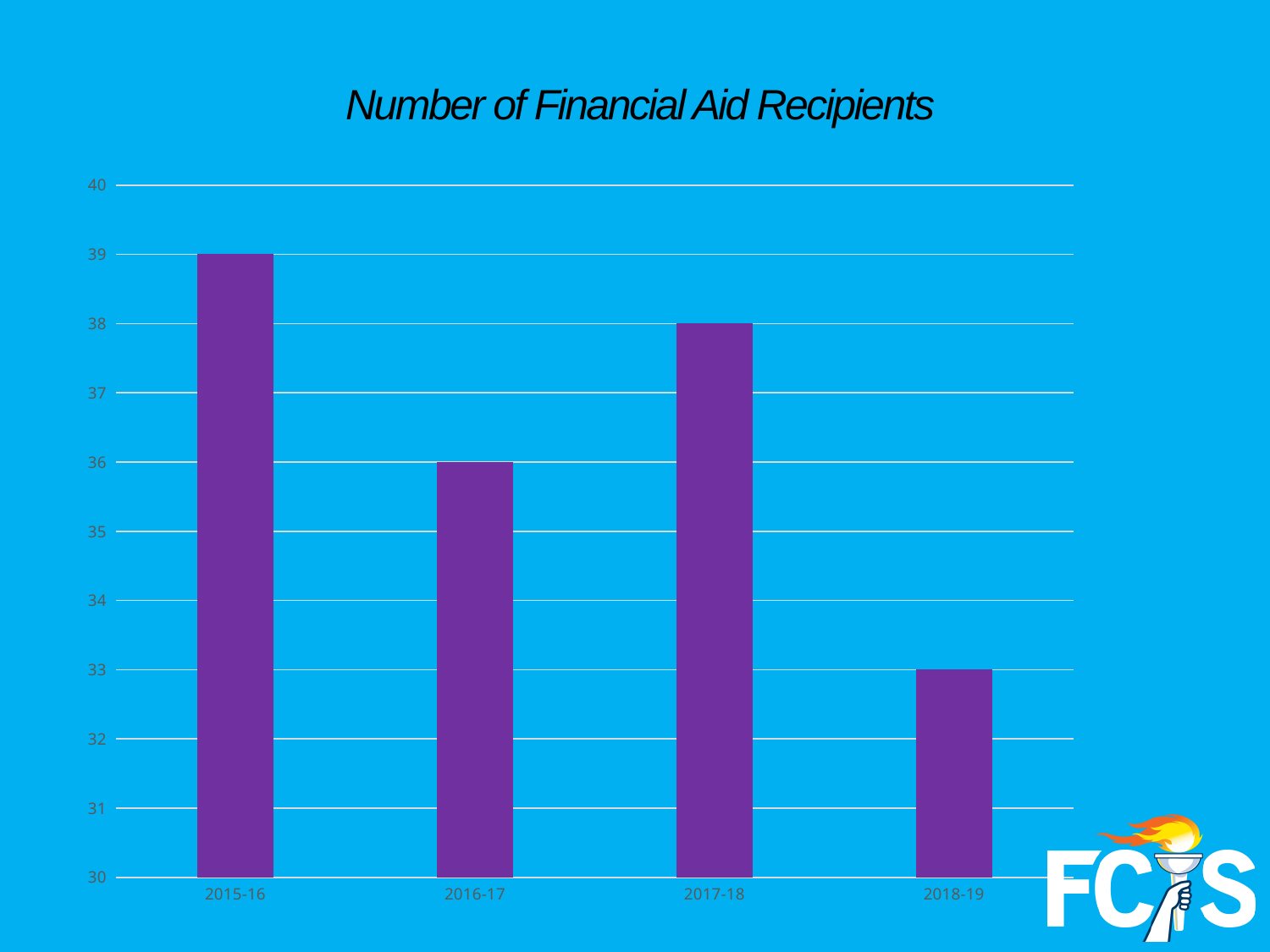
What is the number of financial aid recipients for 2018-19? 33 Which year has more financial aid recipients, 2016-17 or 2017-18? 2017-18 Which year has the lowest number of financial aid recipients? 2018-19 What is the difference in the number of financial aid recipients between 2015-16 and 2018-19? 6 Is the value for 2018-19 greater or less than 35? less Which year has the highest number of financial aid recipients? 2015-16 What is the title of the chart? Number of Financial Aid Recipients What kind of chart is shown on the slide? bar chart What is the number of financial aid recipients for 2015-16? 39 How many years are shown on the chart? 4 What is the number of financial aid recipients for 2016-17? 36 What is the number of financial aid recipients for 2017-18? 38